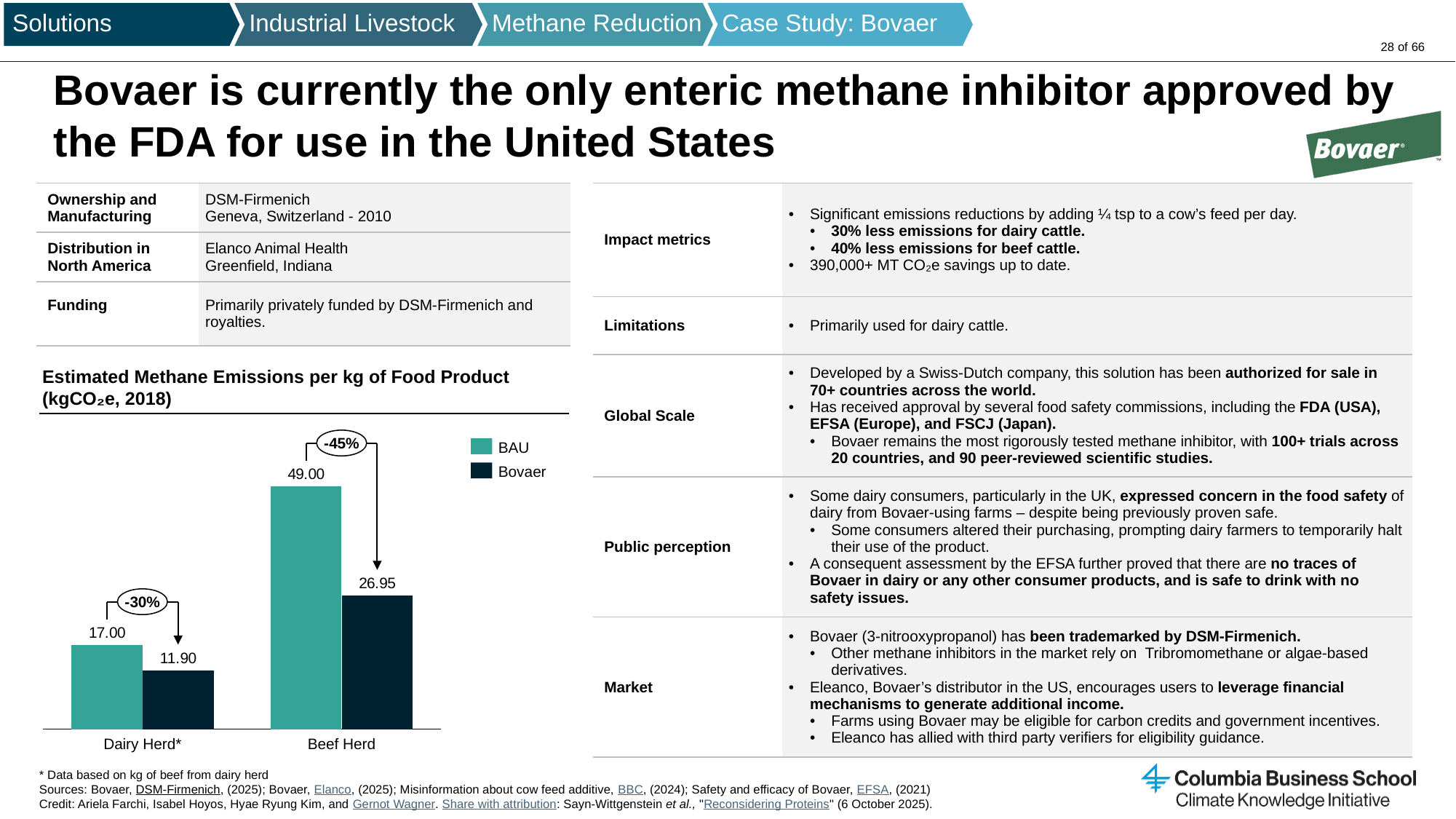
What is the BAU value for Beef Herd in the Estimated Methane Emissions per kg of Food Product chart? 49.00 Which bar in the Estimated Methane Emissions chart has the lowest value? Dairy Herd* Bovaer What percentage reduction is annotated above the Beef Herd bars in the Estimated Methane Emissions chart? -45% How many series does the legend of the Estimated Methane Emissions chart list? 2 What is the Bovaer value for Beef Herd in the Estimated Methane Emissions chart? 26.95 In the Estimated Methane Emissions chart, is the Bovaer value for Beef Herd larger or smaller than the BAU value for Dairy Herd*? larger What is the difference between the BAU and Bovaer values for Dairy Herd* in the Estimated Methane Emissions chart? 5.10 What is the difference between the BAU and Bovaer values for Beef Herd in the Estimated Methane Emissions chart? 22.05 What is the Bovaer value for Dairy Herd* in the Estimated Methane Emissions chart? 11.90 How many categories are shown on the x axis of the Estimated Methane Emissions chart? 2 What is the BAU value for Dairy Herd* in the Estimated Methane Emissions chart? 17.00 Which bar in the Estimated Methane Emissions chart has the highest value? Beef Herd BAU